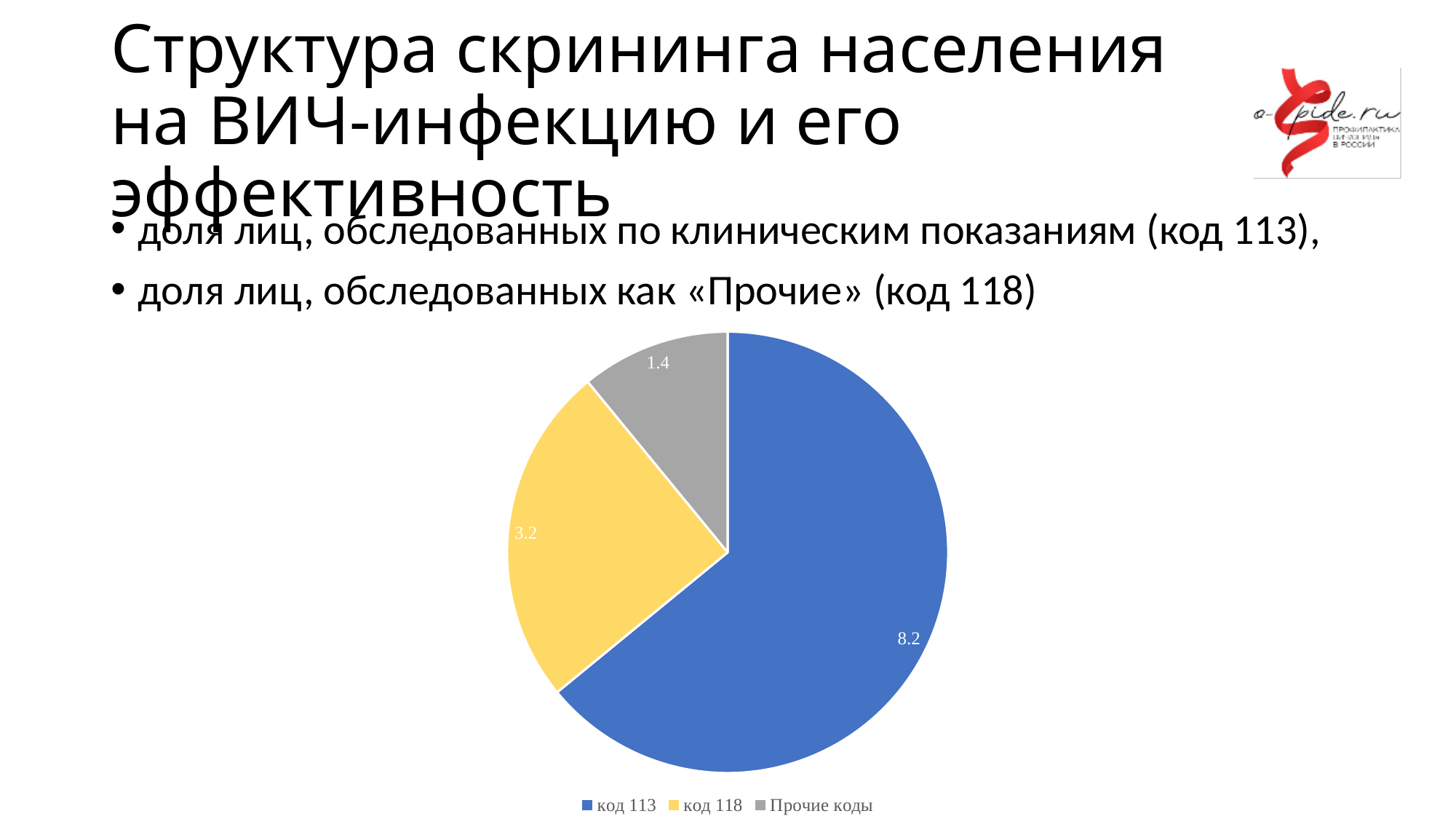
What is the difference between the values for код 113 and код 118? 5.0 Which slice of the pie chart is the smallest? Прочие коды What is the value shown for код 113 in the pie chart? 8.2 What is the difference between the values for код 118 and Прочие коды? 1.8 Which slice of the pie chart is the largest? код 113 What is the value shown for Прочие коды in the pie chart? 1.4 What kind of chart is shown on the slide? pie chart Which is larger, the value for код 118 or the value for Прочие коды? код 118 What colour is the slice for код 113 in the pie chart? blue What share of the pie does the код 118 slice represent? 25% What is the value shown for код 118 in the pie chart? 3.2 How many slices does the pie chart have? 3